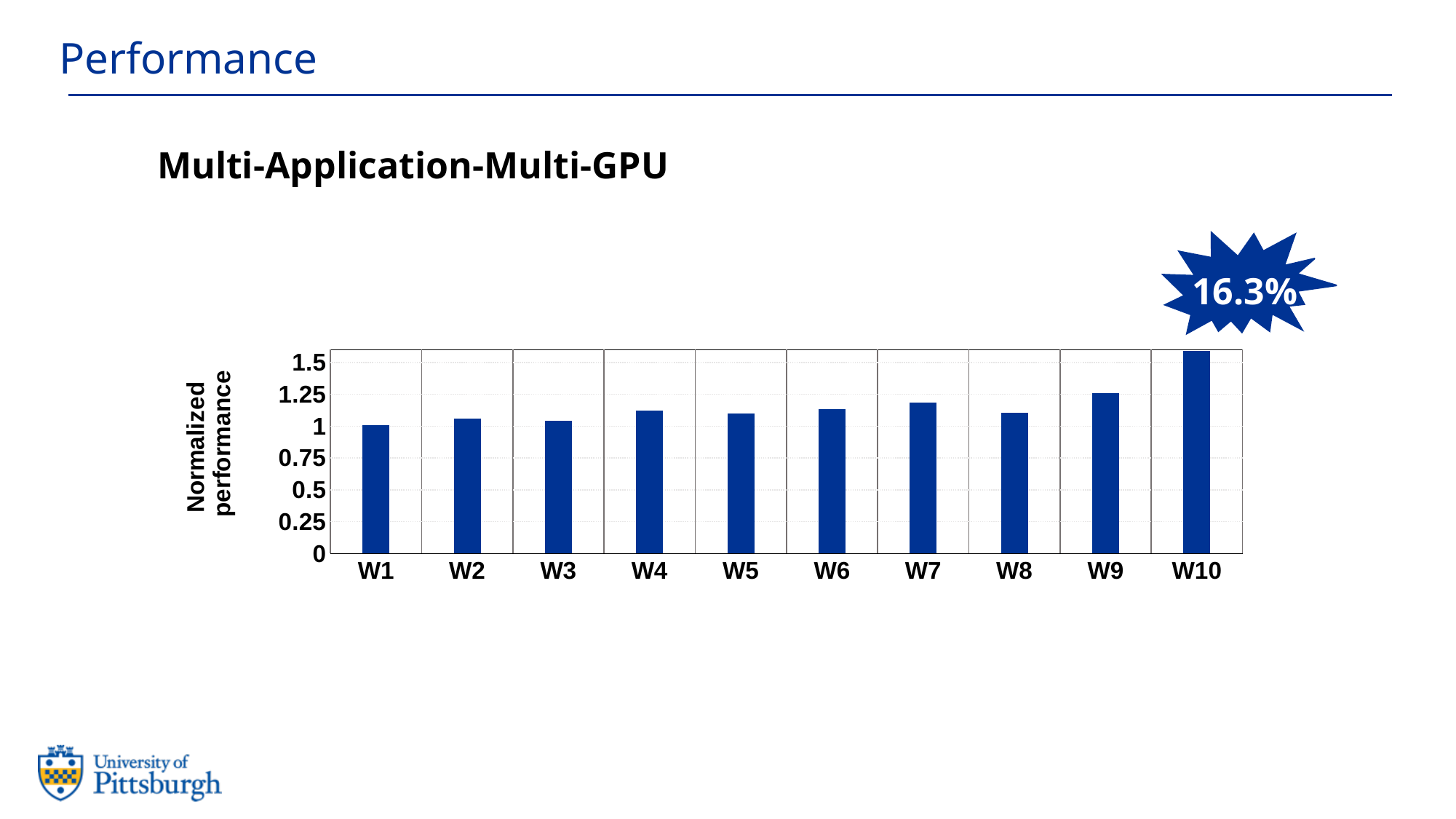
Which workload has the highest normalized performance? W10 What is the label on the y axis of the chart? Normalized performance How many workloads (categories) are plotted on the x axis? 10 Which has the larger normalized performance, W2 or W7? W7 Is the value for W10 greater or less than 1.5? greater What kind of chart is shown on the slide? bar chart Is the value for W7 greater or less than 1? greater What percentage is shown in the starburst callout above the chart? 16.3% Which workload has the lowest normalized performance? W1 Is the value for W4 greater or less than 1.25? less Which has the larger normalized performance, W9 or W4? W9